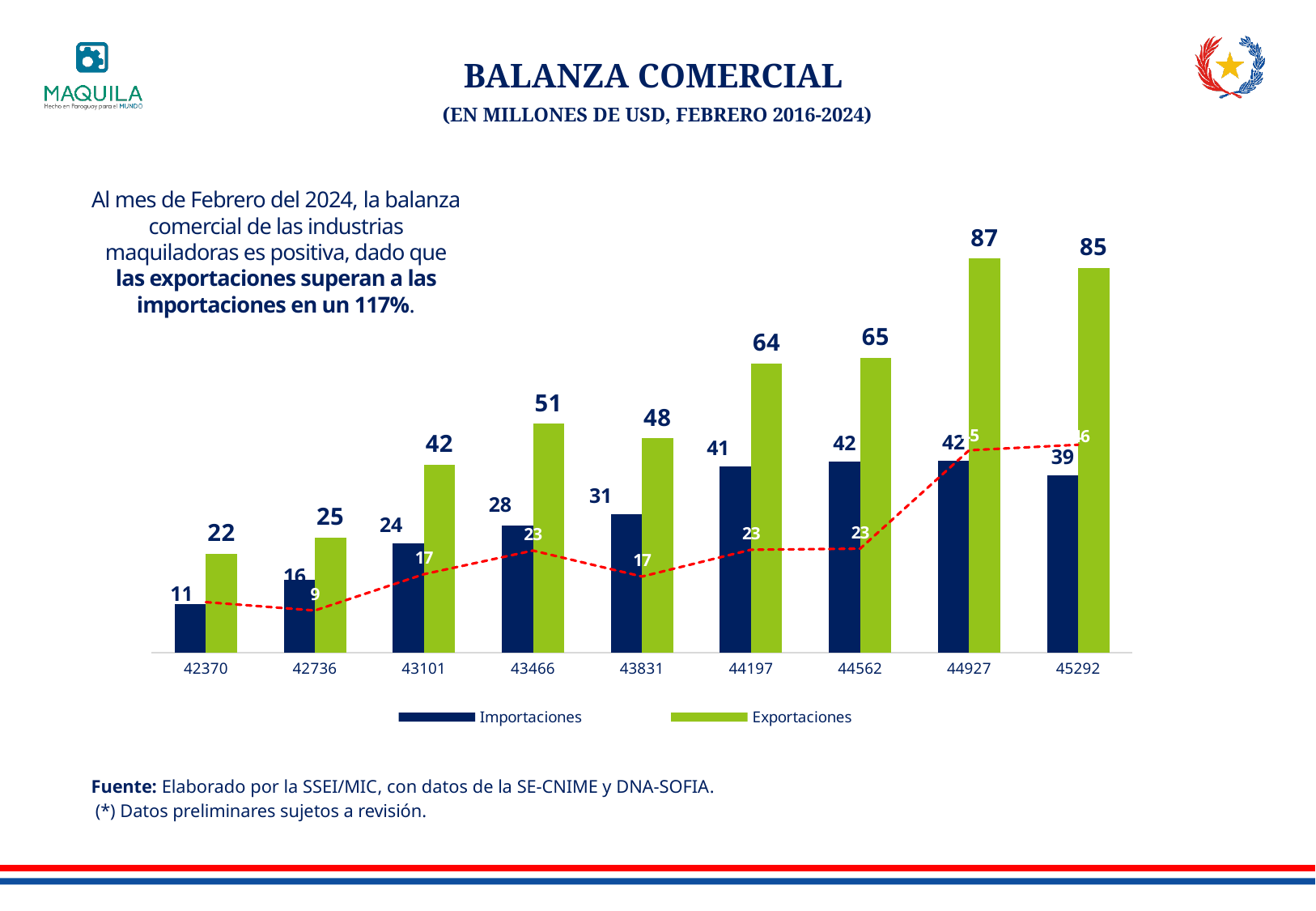
Which category has the lowest Importaciones value? 42370 What is the value of Importaciones for 44562? 42 How many categories are shown on the x axis? 9 What kind of chart is shown on the slide? combination bar and line chart Which is larger, the Exportaciones value for 43466 or for 43831? 43466 What is the value of Exportaciones for 44927? 87 What is the value of Importaciones for 43831? 31 Do the Exportaciones values generally rise or fall from 42370 to 44927? rise Which category has the highest Exportaciones value? 44927 What is the difference between the Exportaciones values for 44927 and 44562? 22 What is the difference between Exportaciones and Importaciones for 45292? 46 How many series does the legend list? 2